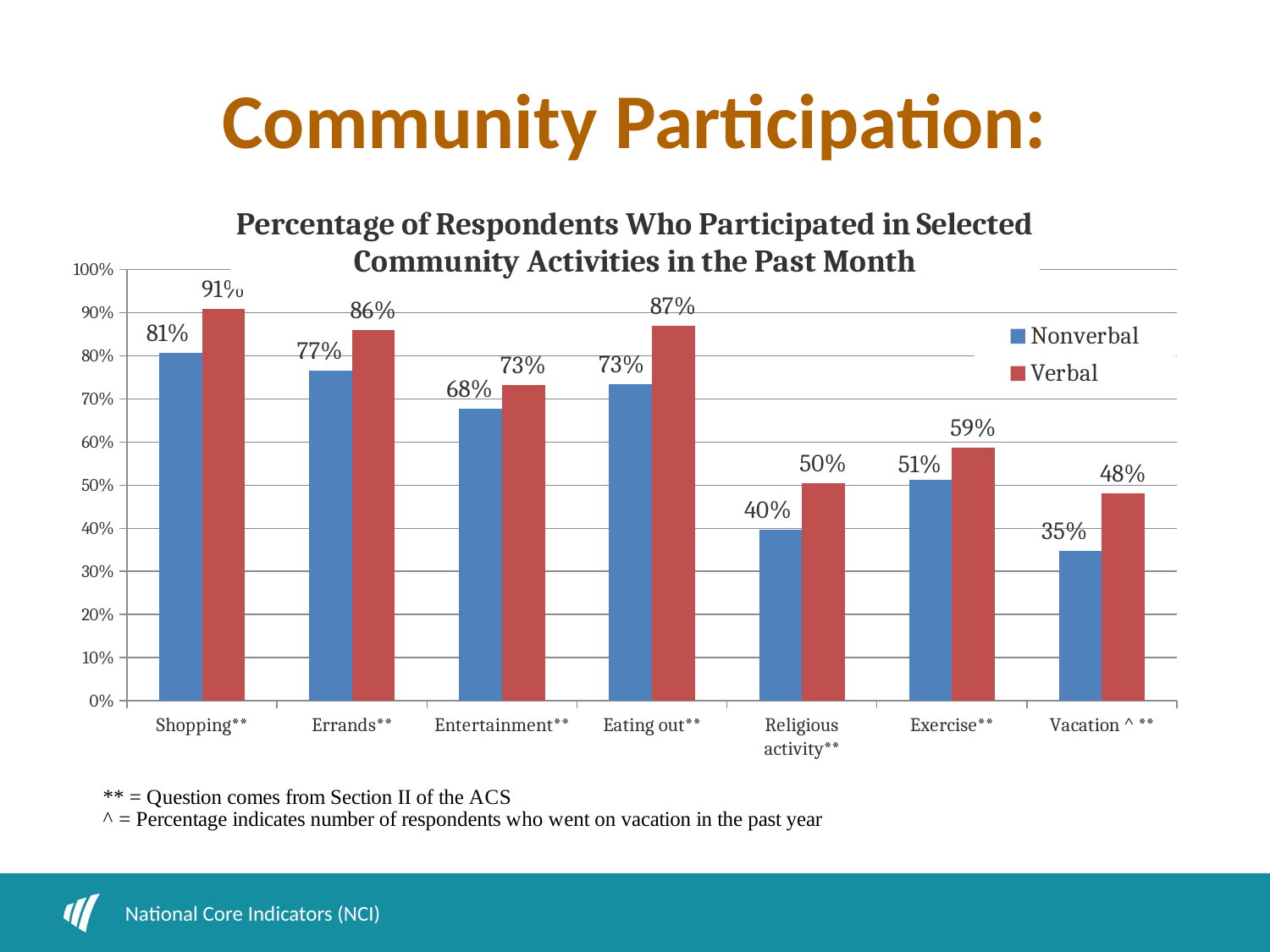
Is the Nonverbal value for Entertainment greater or less than 60%? greater Which is larger for Exercise, the Nonverbal value or the Verbal value? Verbal What is the Verbal value for Shopping? 91% Which colour represents the Verbal series? Red Which activity has the highest Verbal value? Shopping What is the Nonverbal value for Religious activity? 40% How many activity categories are shown on the x axis? 7 Which activity has the lowest Nonverbal value? Vacation What is the difference between the Verbal and Nonverbal values for Eating out? 14% What kind of chart is shown? Bar chart What is the Nonverbal value for Vacation? 35% How many series does the legend list? 2